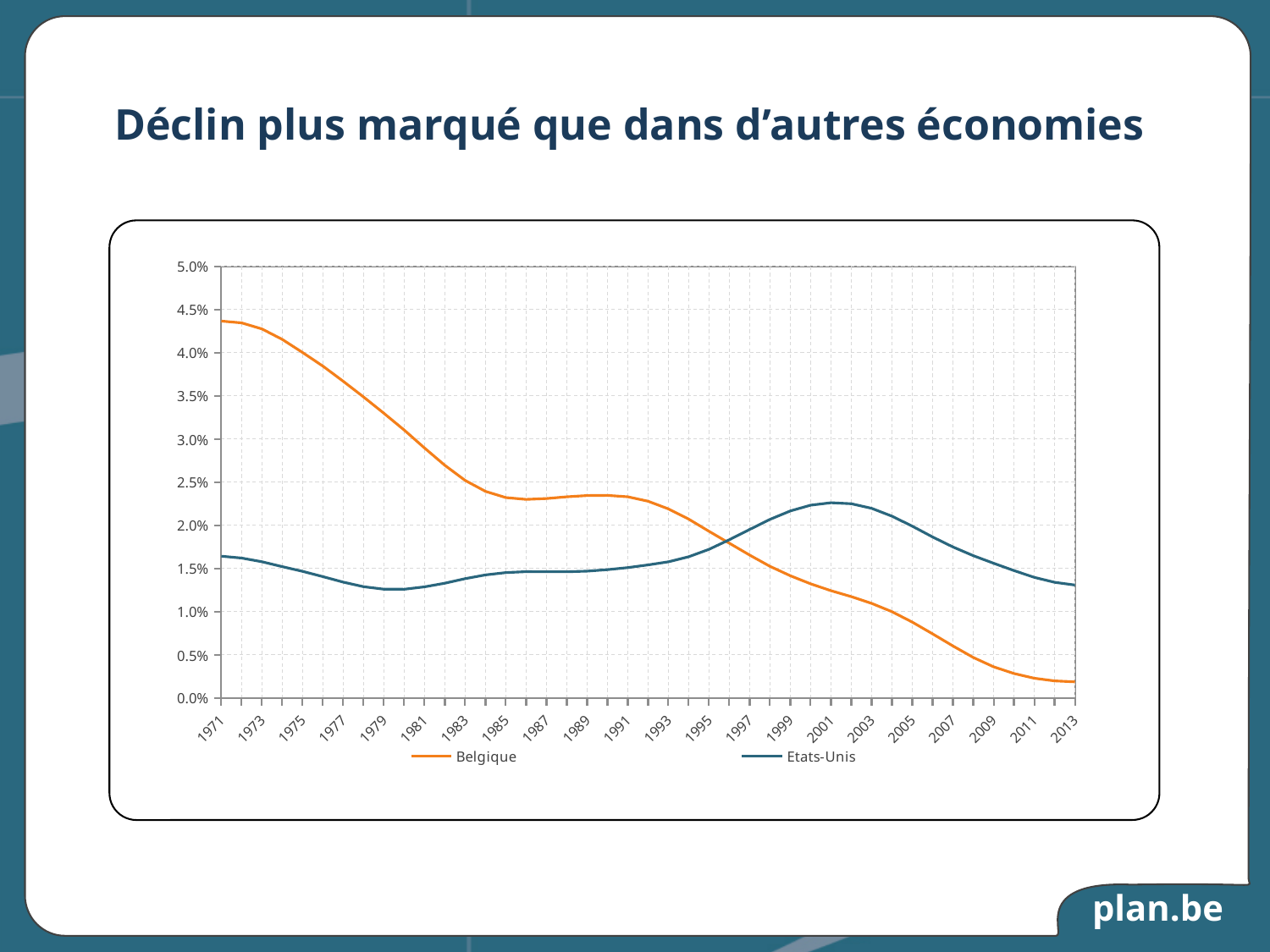
Which series has the higher value in 2013, Belgique or Etats-Unis? Etats-Unis Is the value for Belgique in 2013 greater or less than 0.5%? less What is the title of the slide above the chart? Déclin plus marqué que dans d'autres économies Is the value for Belgique in 1971 greater or less than 4.0%? greater Which series has the higher value in 1991, Belgique or Etats-Unis? Belgique Does the Belgique line rise or fall overall from 1971 to 2013? fall Is the value for Etats-Unis in 2001 greater or less than 2.0%? greater What kind of chart is shown on the slide? line chart Which series has the higher value in 1971, Belgique or Etats-Unis? Belgique How many series does the legend list? 2 What are the two series named in the legend? Belgique and Etats-Unis